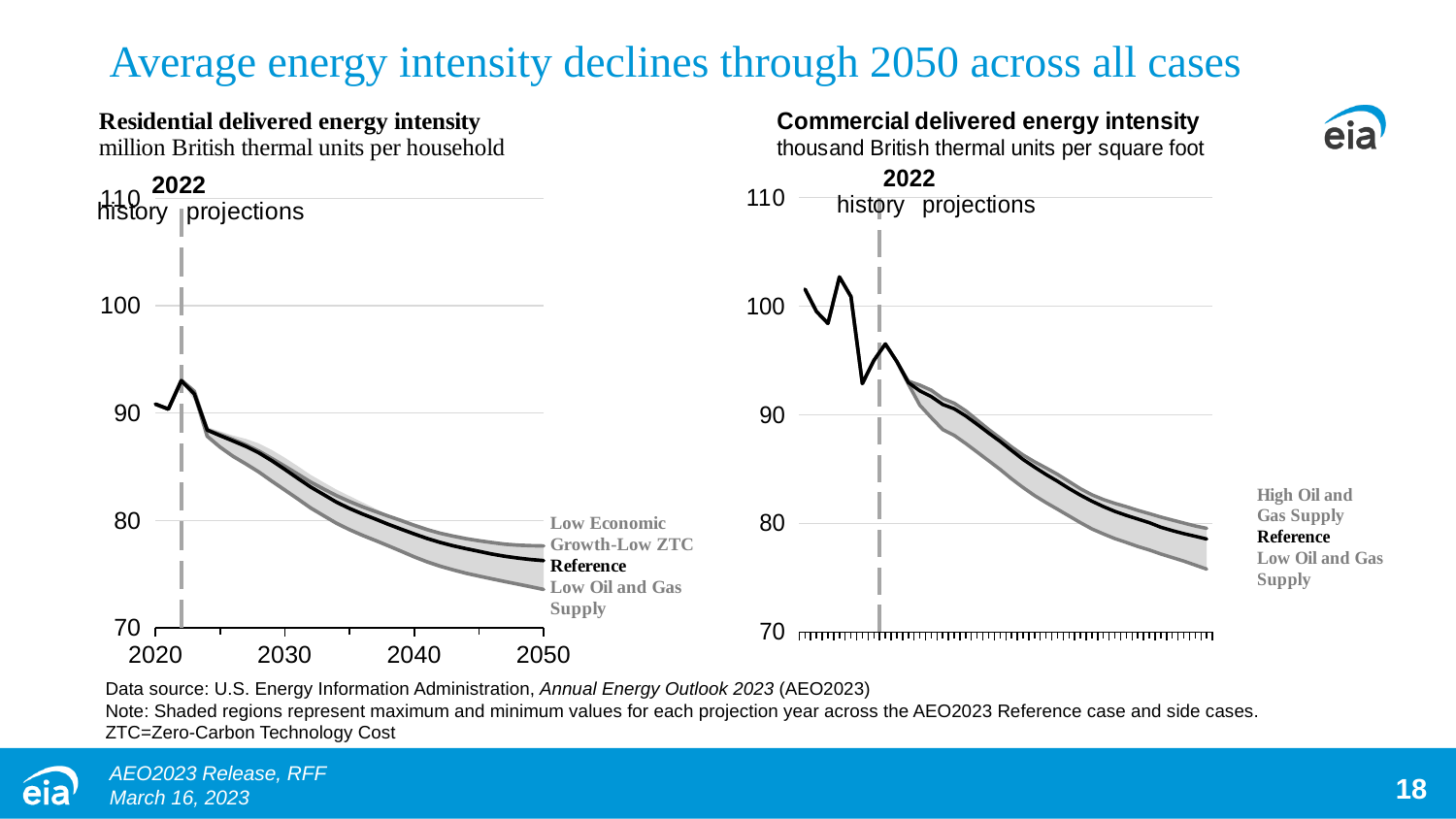
In the Residential delivered energy intensity chart, is the Reference value in 2050 greater or less than 80? less In the Residential delivered energy intensity chart, does the Reference case rise or fall over the projection period? fall In the Commercial delivered energy intensity chart, is the value at the 2022 dashed line greater or less than 100? less In the Residential delivered energy intensity chart, which case is higher in 2050: Low Economic Growth-Low ZTC or Low Oil and Gas Supply? Low Economic Growth-Low ZTC In the Commercial delivered energy intensity chart, is the Reference value at the end of the projection period greater or less than 80? less What type of chart is the Residential delivered energy intensity chart? line chart In the Commercial delivered energy intensity chart, does the Reference case rise or fall over the projection period? fall Which year separates history from projections on both charts? 2022 How many cases are labeled on the Commercial delivered energy intensity chart? 3 What unit is used on the Residential delivered energy intensity chart? million British thermal units per household In the Commercial delivered energy intensity chart, which case is higher at the end of the projection period: High Oil and Gas Supply or Low Oil and Gas Supply? High Oil and Gas Supply